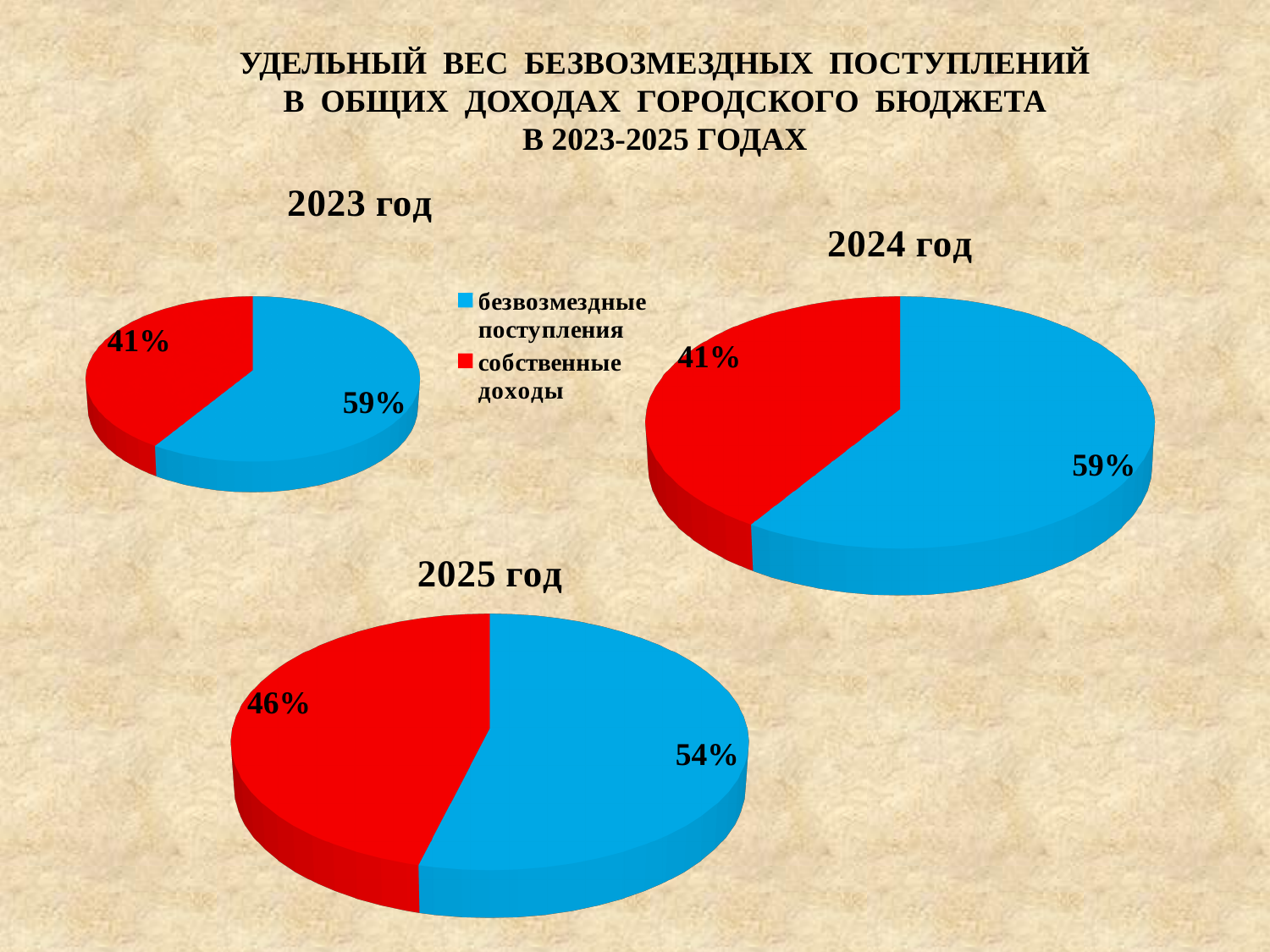
In the 2025 год chart, what is the difference in percentage points between безвозмездные поступления and собственные доходы? 8 How many slices does the 2024 год chart have? 2 In the 2023 год chart, what share is безвозмездные поступления? 59% In the 2025 год chart, what share is собственные доходы? 46% In the 2024 год chart, what share is безвозмездные поступления? 59% How many series does the legend list? 2 What type of chart is used for 2023 год? pie chart In the 2025 год chart, which slice is larger: безвозмездные поступления or собственные доходы? безвозмездные поступления In the 2023 год chart, what share is собственные доходы? 41% In the 2025 год chart, what share is безвозмездные поступления? 54% In the 2024 год chart, which category has the smallest slice? собственные доходы Which colour represents собственные доходы in the charts? red